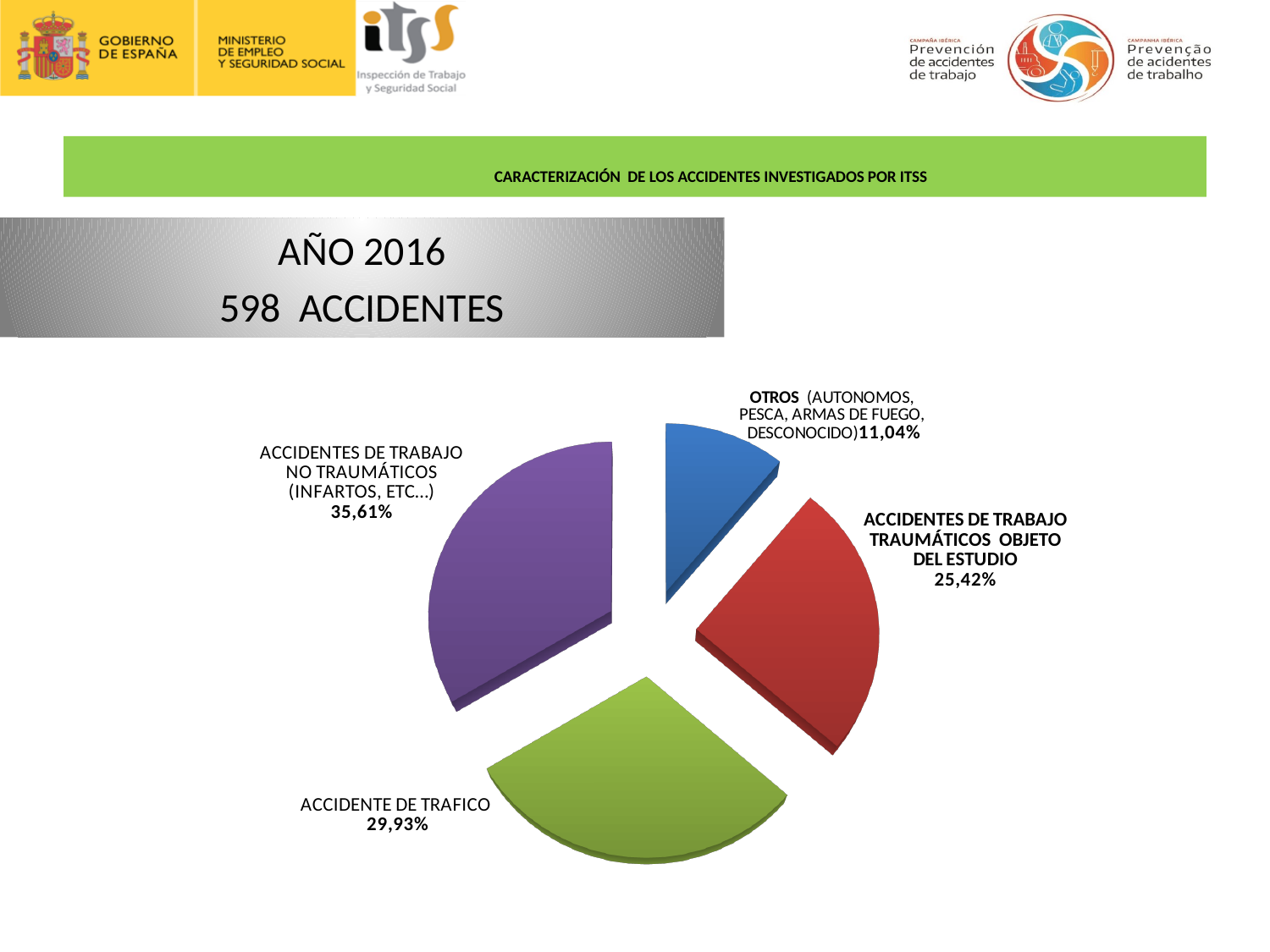
Which category has the smallest share of the pie? OTROS (AUTONOMOS, PESCA, ARMAS DE FUEGO, DESCONOCIDO) What share of the pie is ACCIDENTES DE TRABAJO NO TRAUMÁTICOS (INFARTOS, ETC...)? 35,61% What share of the pie is OTROS (AUTONOMOS, PESCA, ARMAS DE FUEGO, DESCONOCIDO)? 11,04% What kind of chart is shown on the slide? pie chart What share of the pie is ACCIDENTES DE TRABAJO TRAUMÁTICOS OBJETO DEL ESTUDIO? 25,42% Which is larger: the share for ACCIDENTE DE TRAFICO or the share for ACCIDENTES DE TRABAJO TRAUMÁTICOS OBJETO DEL ESTUDIO? ACCIDENTE DE TRAFICO What colour is the slice for ACCIDENTE DE TRAFICO? green What is the difference in percentage points between ACCIDENTES DE TRABAJO TRAUMÁTICOS OBJETO DEL ESTUDIO and OTROS? 14,38 Which category has the largest share of the pie? ACCIDENTES DE TRABAJO NO TRAUMÁTICOS (INFARTOS, ETC...) How many slices does the pie chart have? 4 What is the difference in percentage points between ACCIDENTES DE TRABAJO NO TRAUMÁTICOS and ACCIDENTE DE TRAFICO? 5,68